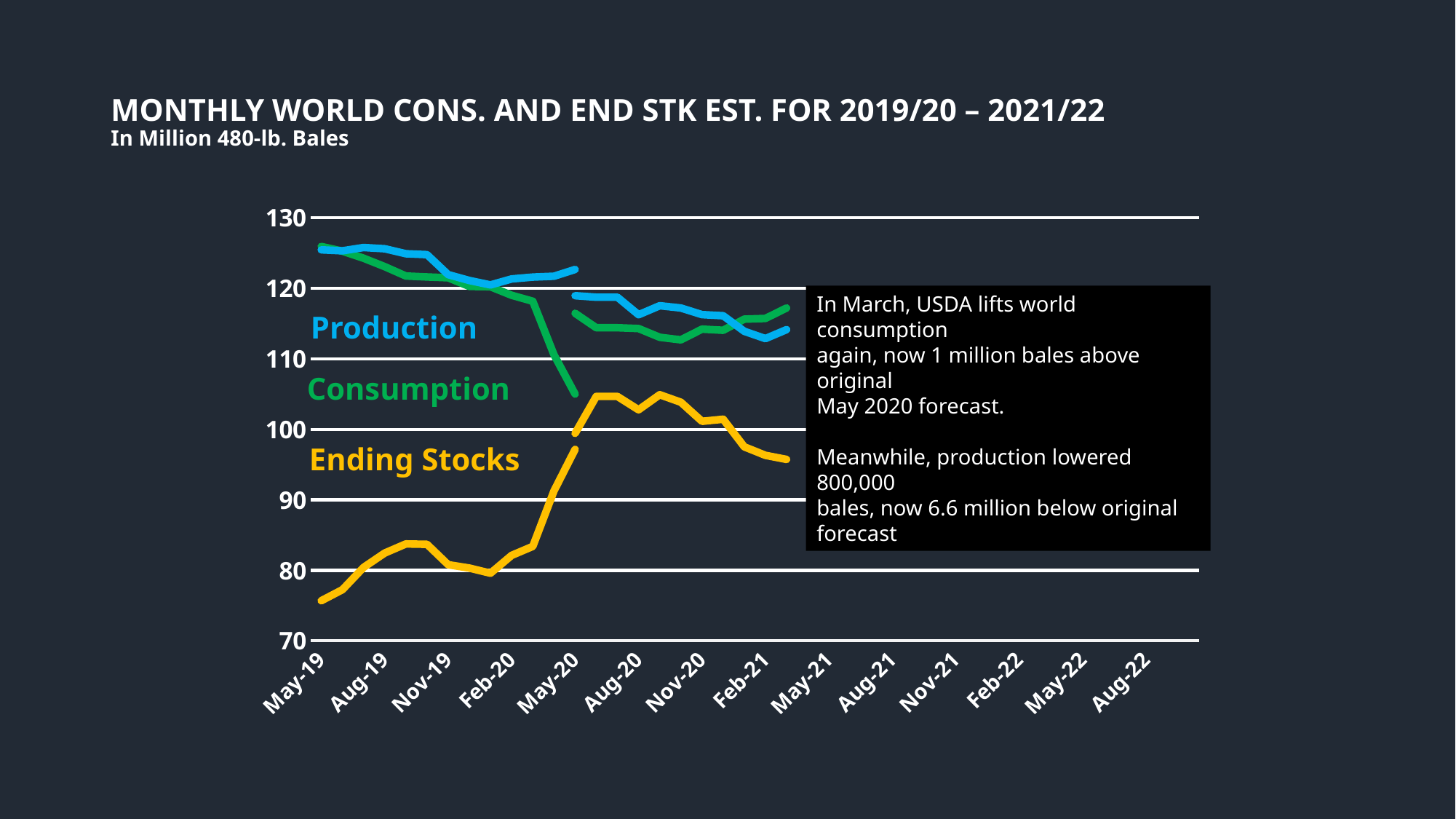
What kind of chart is shown on the slide? Line chart Is the value for Ending Stocks at May-19 greater or less than 80? less Does the Consumption line rise or fall between May-19 and May-20? fall What colour is the Ending Stocks line? Yellow How many month labels are shown along the x axis? 14 How many series are labelled on the chart? 3 Is the value for Production at May-19 greater or less than 120? greater Does the Ending Stocks line rise or fall between May-19 and May-20? rise What unit is stated under the chart title? In Million 480-lb. Bales Is the value for Ending Stocks at Aug-20 greater or less than 100? greater At May-19, which is larger: Production or Ending Stocks? Production